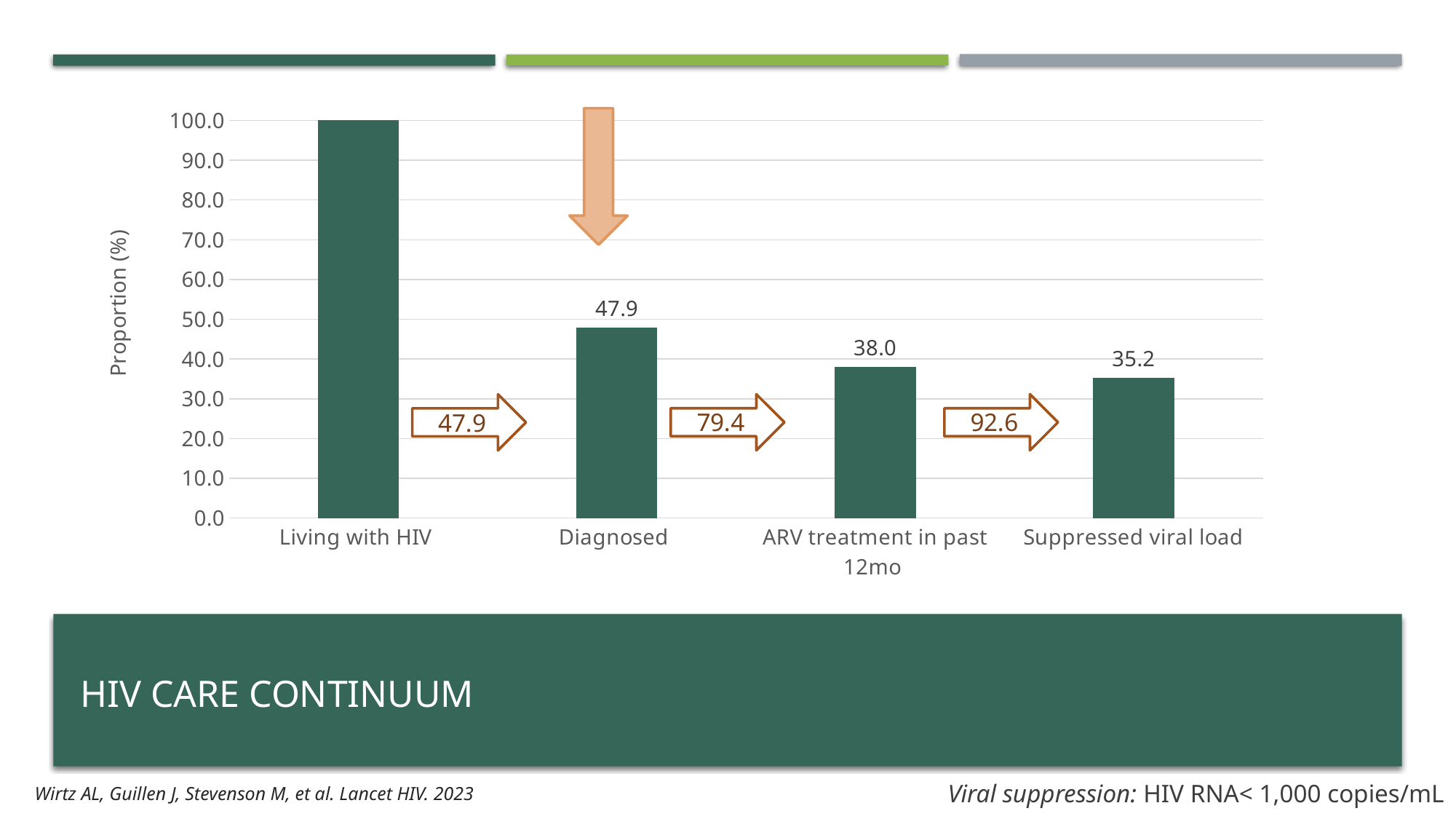
Which is larger, the value for Diagnosed or the value for Suppressed viral load? Diagnosed Which category has the highest value? Living with HIV What is the value for Suppressed viral load? 35.2 What kind of chart is shown on the slide? bar chart How many categories are shown on the x axis? 4 Which category has the lowest value? Suppressed viral load What is the value for Diagnosed? 47.9 What is the value for ARV treatment in past 12mo? 38.0 What is the label on the y axis? Proportion (%) Do the values rise or fall from left to right along the x axis? fall Is the value for Living with HIV greater or less than 90.0? greater What is the difference between the values for Diagnosed and ARV treatment in past 12mo? 9.9